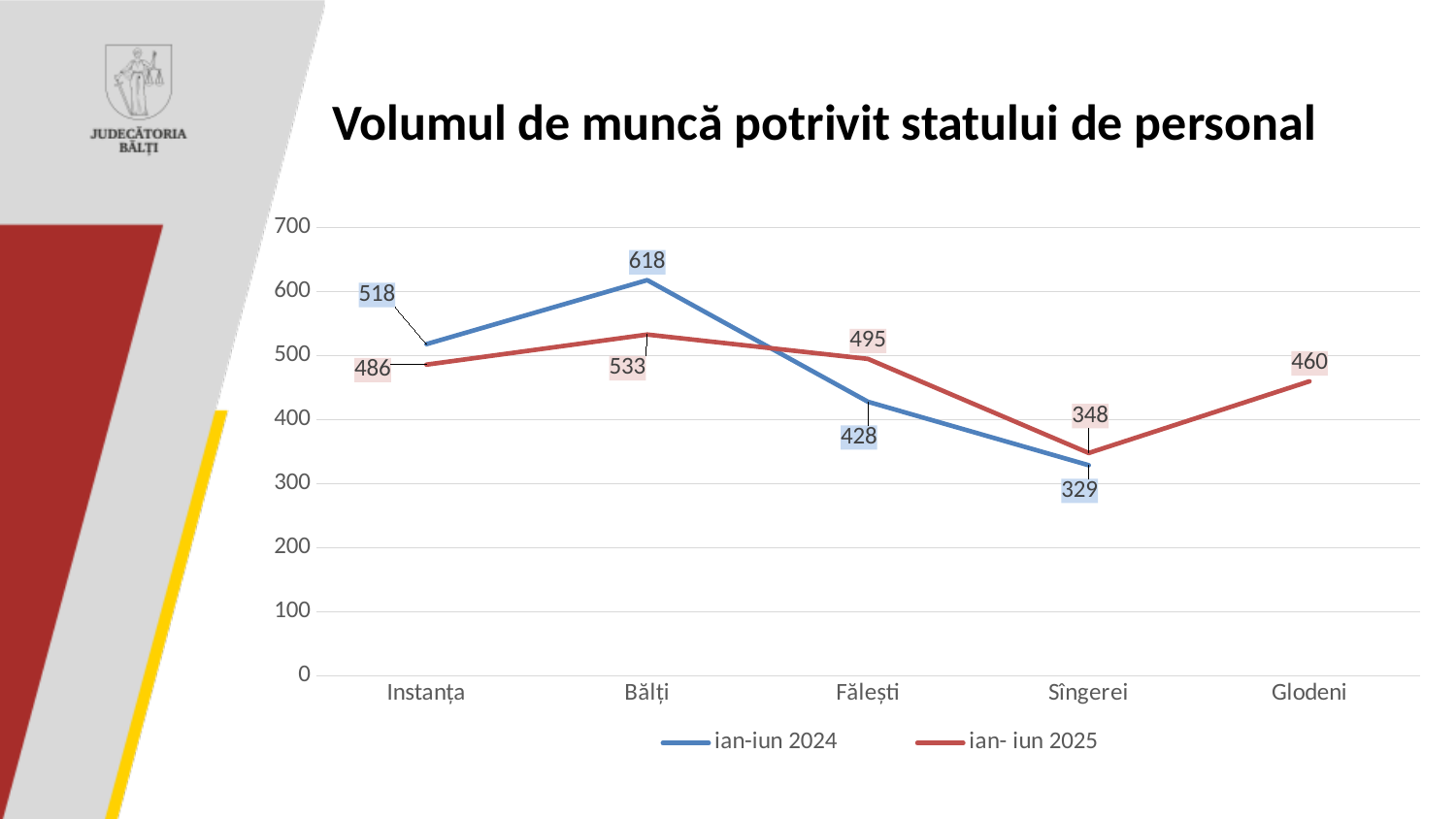
For Fălești, which series has the larger value, ian-iun 2024 or ian- iun 2025? ian- iun 2025 What is the value for Bălți in the ian-iun 2024 series? 618 What is the difference between the ian-iun 2024 and ian- iun 2025 values for Bălți? 85 Which category has the highest value in the ian- iun 2025 series? Bălți What is the title of the chart? Volumul de muncă potrivit statului de personal How many series does the legend list? 2 How many categories are shown on the x axis? 5 What is the value for Glodeni in the ian- iun 2025 series? 460 Which category has the lowest value in the ian- iun 2025 series? Sîngerei Does the ian-iun 2024 series rise or fall from Bălți to Sîngerei? fall What kind of chart is shown on the slide? line chart What is the value for Sîngerei in the ian-iun 2024 series? 329